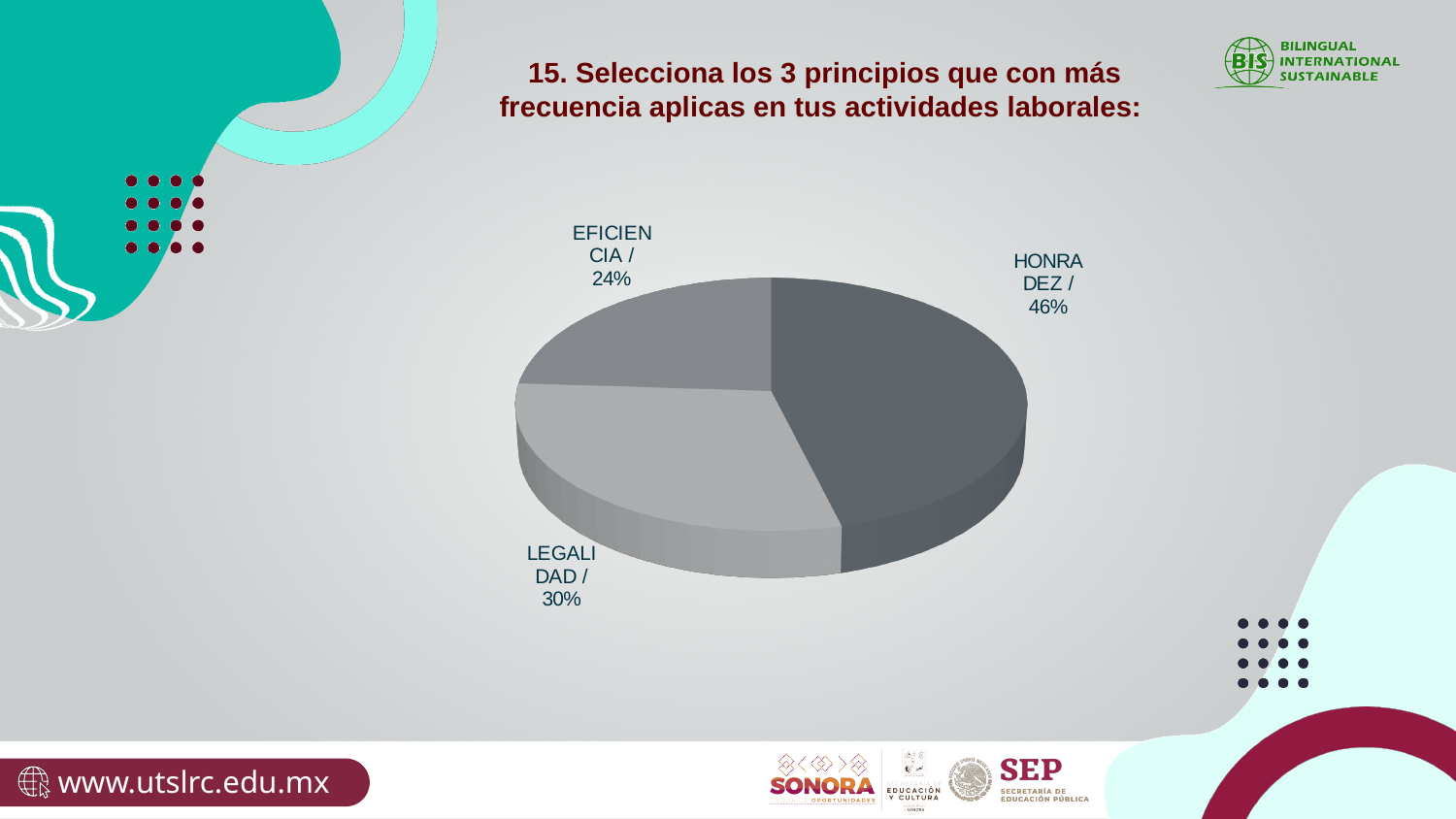
Which principle has the largest slice of the pie? HONRADEZ Which principle has the smallest slice of the pie? EFICIENCIA How many slices does the pie chart have? 3 What is the combined share of HONRADEZ and LEGALIDAD? 76% What is the difference in percentage points between LEGALIDAD and EFICIENCIA? 6 What is the difference in percentage points between HONRADEZ and LEGALIDAD? 16 What share of the pie does EFICIENCIA represent? 24% Which is larger, the share for LEGALIDAD or the share for EFICIENCIA? LEGALIDAD What share of the pie does LEGALIDAD represent? 30% What is the number of the survey question shown in the slide title? 15 What kind of chart is shown on the slide? Pie chart What share of the pie does HONRADEZ represent? 46%